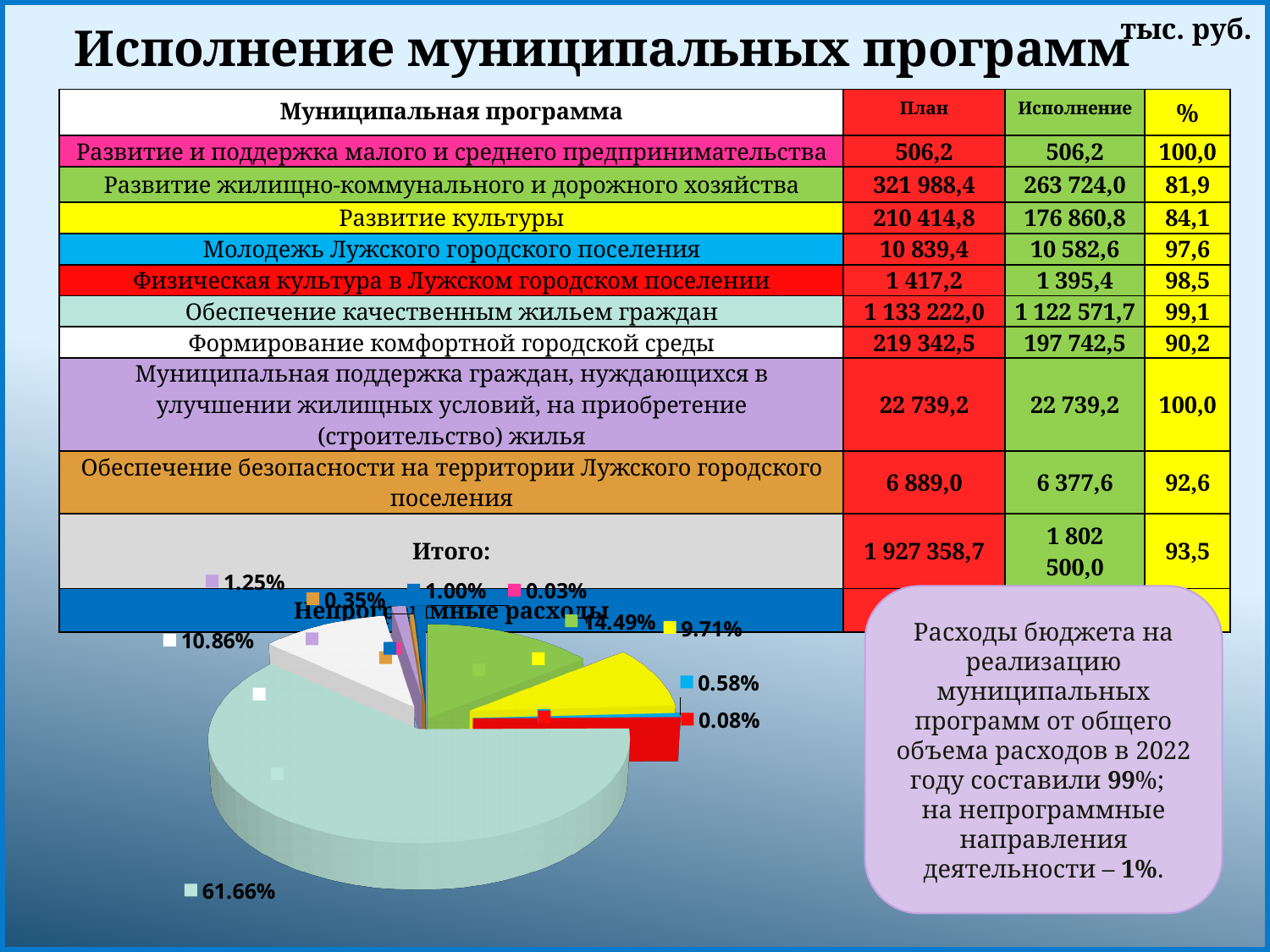
In the pie chart, what share is shown for the white slice? 10.86% In the pie chart, what is the value of the largest slice? 61.66% In the pie chart, what is the value of the smallest labelled slice? 0.03% In the pie chart, what share is shown for the light teal (mint) slice? 61.66% In the pie chart, what is the difference between the 14.49% slice and the 9.71% slice? 4.78% What kind of chart is shown at the bottom left of the slide? pie chart In the pie chart, is the green slice greater or less than 20%? less In the pie chart, which is larger: the slice labelled 0.58% or the slice labelled 0.08%? 0.58% In the pie chart, what is the difference between the 61.66% slice and the 14.49% slice? 47.17% In the pie chart, which is larger: the slice labelled 10.86% or the slice labelled 9.71%? 10.86% In the pie chart, is the largest slice greater or less than 50%? greater In the pie chart, what is the second-largest labelled slice value? 14.49%